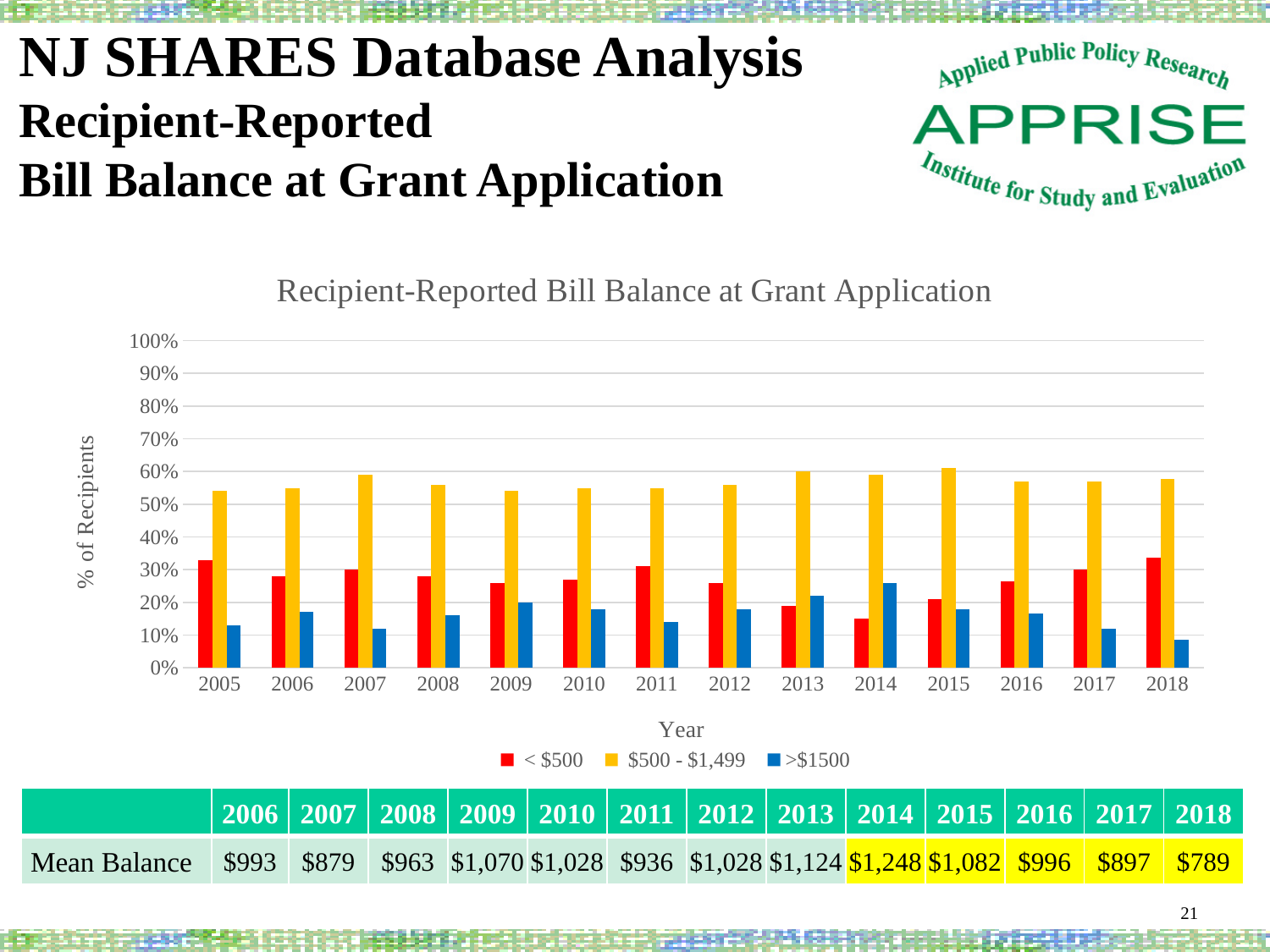
In which year is the < $500 series at its lowest? 2014 Is the value for the < $500 series in 2005 greater or less than 30%? greater Is the value for the >$1500 series in 2018 greater or less than 10%? less What is the label on the chart's vertical axis? % of Recipients Is the value for the >$1500 series in 2014 greater or less than 20%? greater In 2014, which is larger: the < $500 series or the >$1500 series? >$1500 How many years are shown along the x axis of the chart? 14 In which year is the >$1500 series at its lowest? 2018 How many series does the chart's legend list? 3 What is the title of the chart? Recipient-Reported Bill Balance at Grant Application What kind of chart is shown on the slide? bar chart